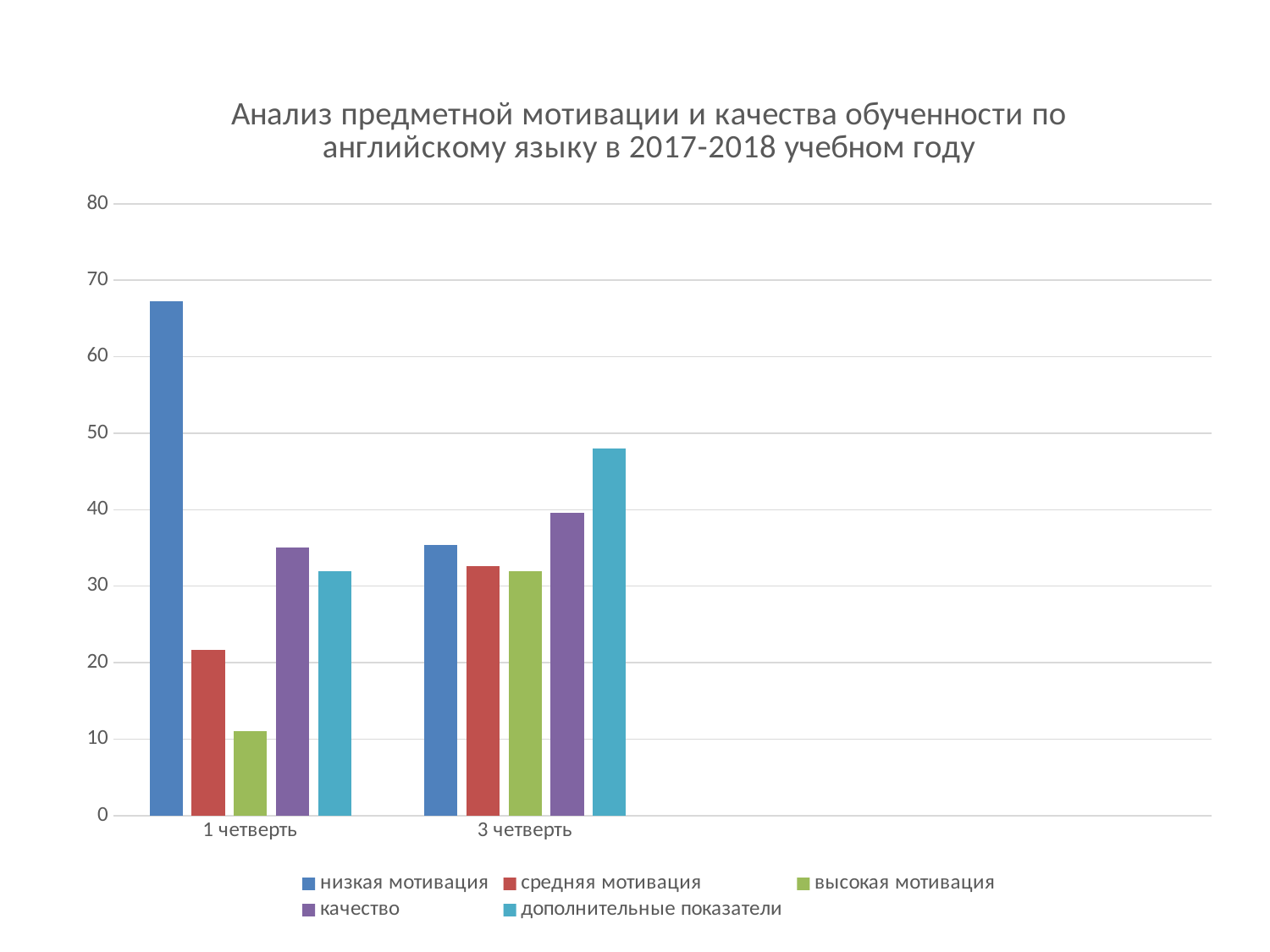
What kind of chart is shown on the slide? bar chart How many series does the legend list? 5 Which series has the lowest value for 1 четверть? высокая мотивация Which series has the highest value for 1 четверть? низкая мотивация Is the value for высокая мотивация in 1 четверть greater or less than 20? less Does the value for высокая мотивация rise or fall from 1 четверть to 3 четверть? rise Is the value for дополнительные показатели in 3 четверть greater or less than 40? greater What is the title of the chart? Анализ предметной мотивации и качества обученности по английскому языку в 2017-2018 учебном году Is the value for низкая мотивация in 1 четверть greater or less than 60? greater Which is larger for низкая мотивация: the value for 1 четверть or for 3 четверть? 1 четверть Which series has the highest value for 3 четверть? дополнительные показатели How many categories are shown on the x axis? 2